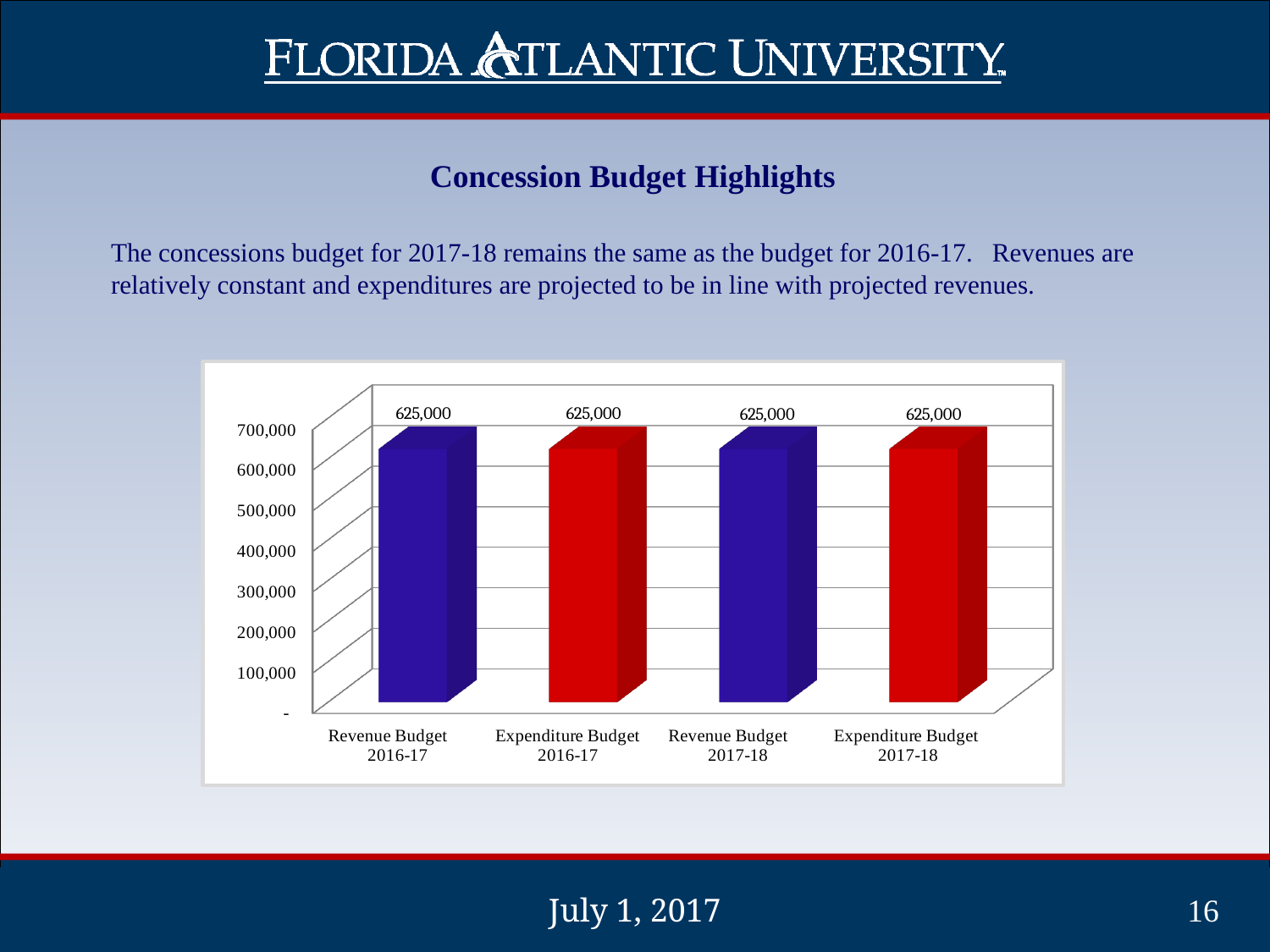
Do the values rise, fall, or stay the same across the categories from left to right? Stay the same How many bars are shown in the chart? 4 What is the value for Revenue Budget 2016-17? 625,000 Is the value for Revenue Budget 2017-18 greater or less than 700,000? less What is the value for Revenue Budget 2017-18? 625,000 What is the total of Revenue Budget 2017-18 and Expenditure Budget 2017-18? 1,250,000 What colour are the Expenditure Budget bars? Red What kind of chart is shown on the slide? Bar chart What is the value for Expenditure Budget 2017-18? 625,000 What colour are the Revenue Budget bars? Blue Is the value for Expenditure Budget 2016-17 greater or less than 600,000? greater What is the difference between Revenue Budget 2016-17 and Expenditure Budget 2016-17? 0